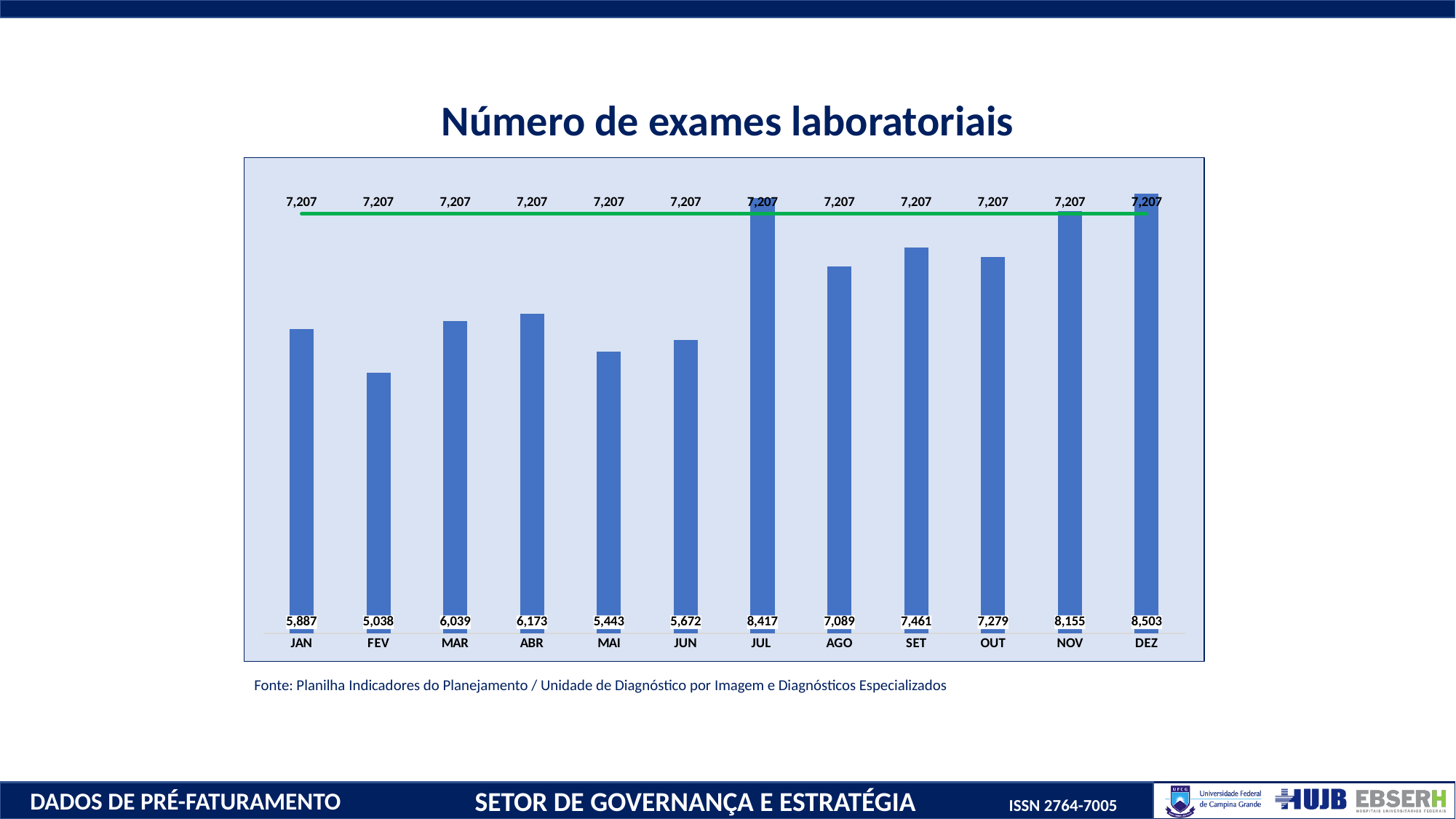
Is the value for AGO greater or less than the green line value of 7,207? less Which month has the highest number of laboratory exams? DEZ What value does the green line show for each month? 7,207 What is the difference between the values for DEZ and JUL? 86 What is the difference between the values for JUL and JAN? 2,530 Which month has the lowest number of laboratory exams? FEV Which is larger, the value for NOV or the value for SET? NOV What is the value shown for FEV? 5,038 What is the number of laboratory exams shown for JUL? 8,417 How many months are shown on the x axis? 12 What kind of chart is shown on the slide? combination bar and line chart What is the title of the chart? Número de exames laboratoriais